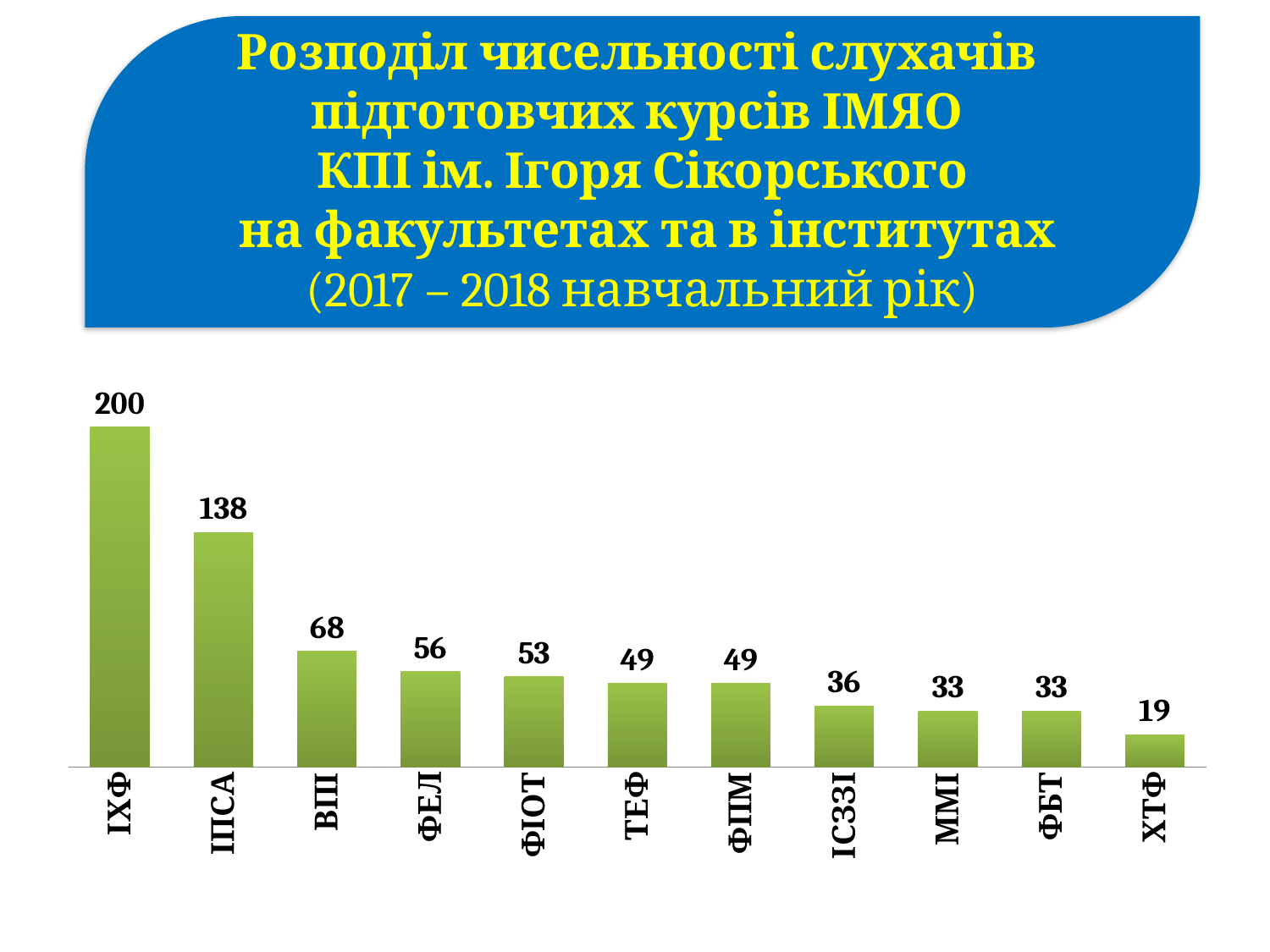
What is the value for ФІОТ? 53 What is the value for ІХФ? 200 Which category has the highest value? ІХФ Which category has the lowest value? ХТФ What is the value for ІСЗЗІ? 36 Which is larger, the value for ФЕЛ or the value for ММІ? ФЕЛ What kind of chart is shown on the slide? bar chart What is the difference between the values for ВПІ and ХТФ? 49 What is the value for ІПСА? 138 How many categories are shown on the x axis? 11 What is the difference between the values for ІХФ and ІПСА? 62 Do the values rise or fall from left to right along the x axis? fall